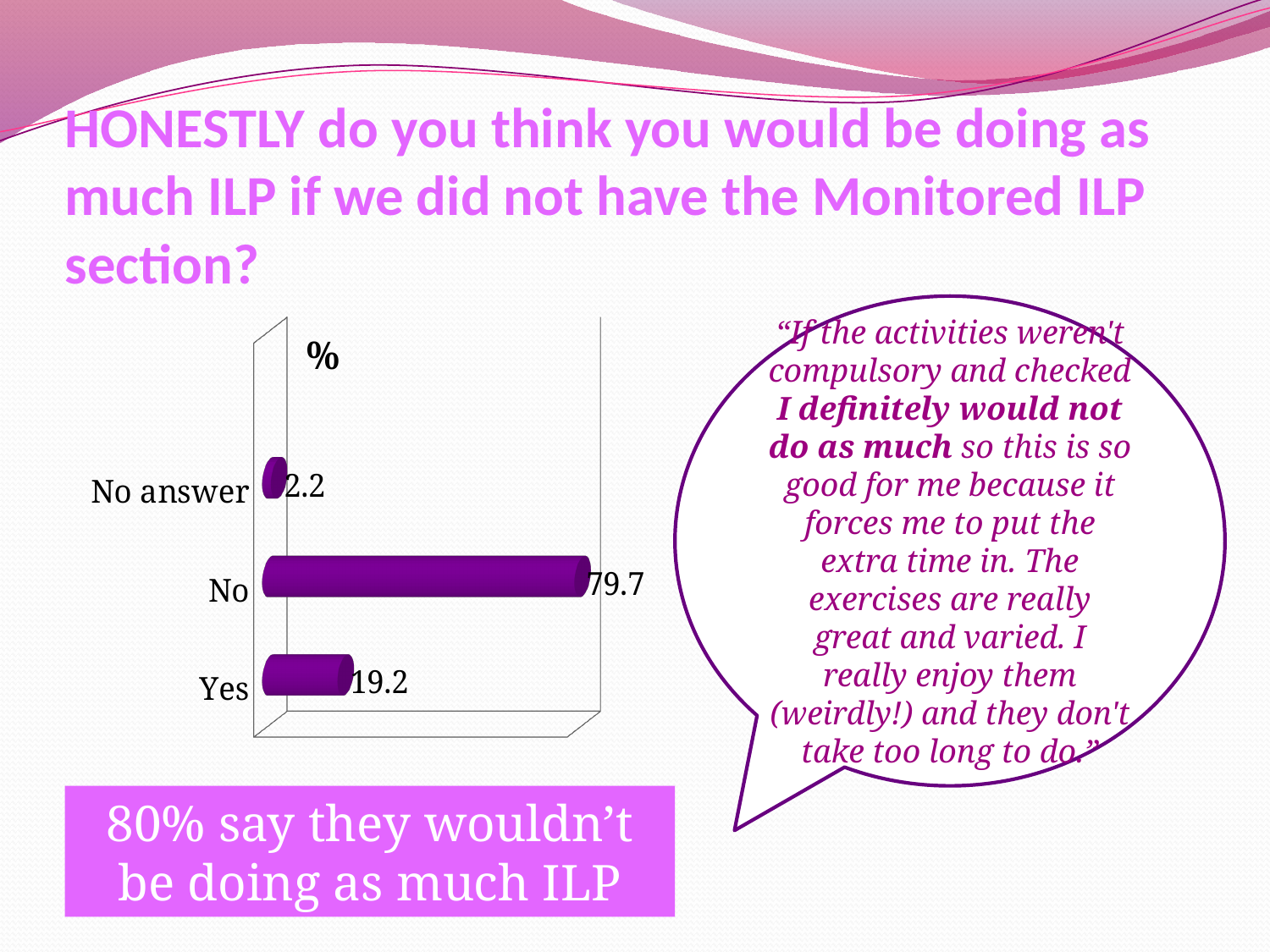
Which category has the highest value in the chart? No What is the value for "Yes" in the chart? 19.2 Which category has the lowest value in the chart? No answer Which is larger, the value for "Yes" or the value for "No answer"? Yes What colour are the bars in the chart? Purple What is the difference between the values for "No" and "Yes"? 60.5 What is the difference between the values for "Yes" and "No answer"? 17.0 What is the value for "No answer" in the chart? 2.2 How many categories are shown in the chart? 3 What is the value for "No" in the chart? 79.7 What kind of chart is shown on the slide? Bar chart What is the title of the chart? %